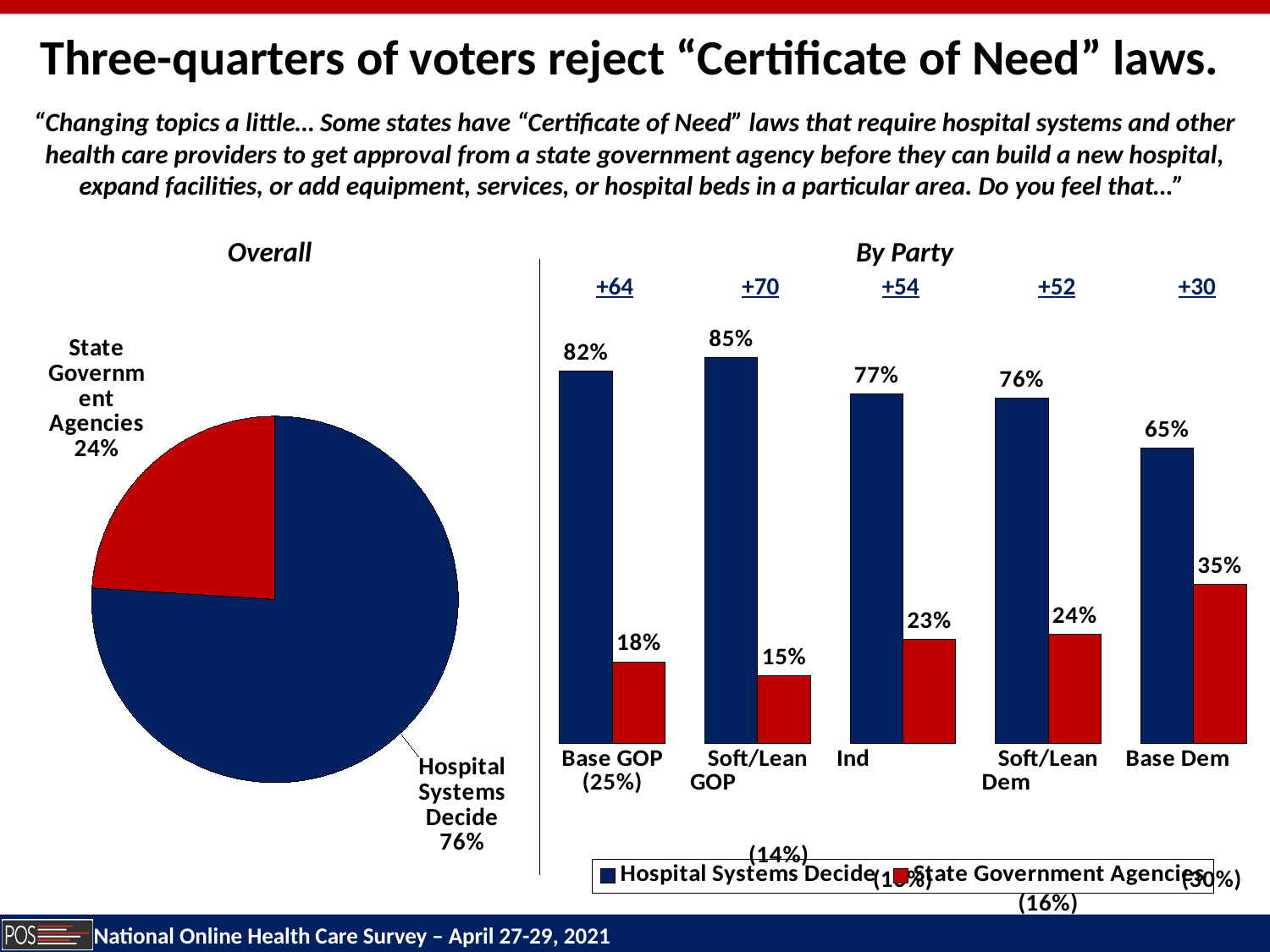
In the "By Party" chart, which is larger: the State Government Agencies value for Ind or for Soft/Lean Dem? Soft/Lean Dem How many party groups are shown in the "By Party" chart? 5 In the "By Party" chart, which party group has the lowest State Government Agencies value? Soft/Lean GOP In the "By Party" chart, what is the State Government Agencies value for Base Dem? 35% In the "By Party" chart, what is the Hospital Systems Decide value for Soft/Lean GOP? 85% In the "Overall" pie chart, what share of voters say Hospital Systems Decide? 76% What kind of chart is the "Overall" chart on the left? Pie chart How many series does the legend of the "By Party" chart list? 2 In the "Overall" pie chart, what share of voters say State Government Agencies? 24% What kind of chart is the "By Party" chart on the right? Bar chart In the "By Party" chart, what is the difference between the Hospital Systems Decide value for Base GOP and for Base Dem? 17 percentage points In the "By Party" chart, which party group has the highest Hospital Systems Decide value? Soft/Lean GOP